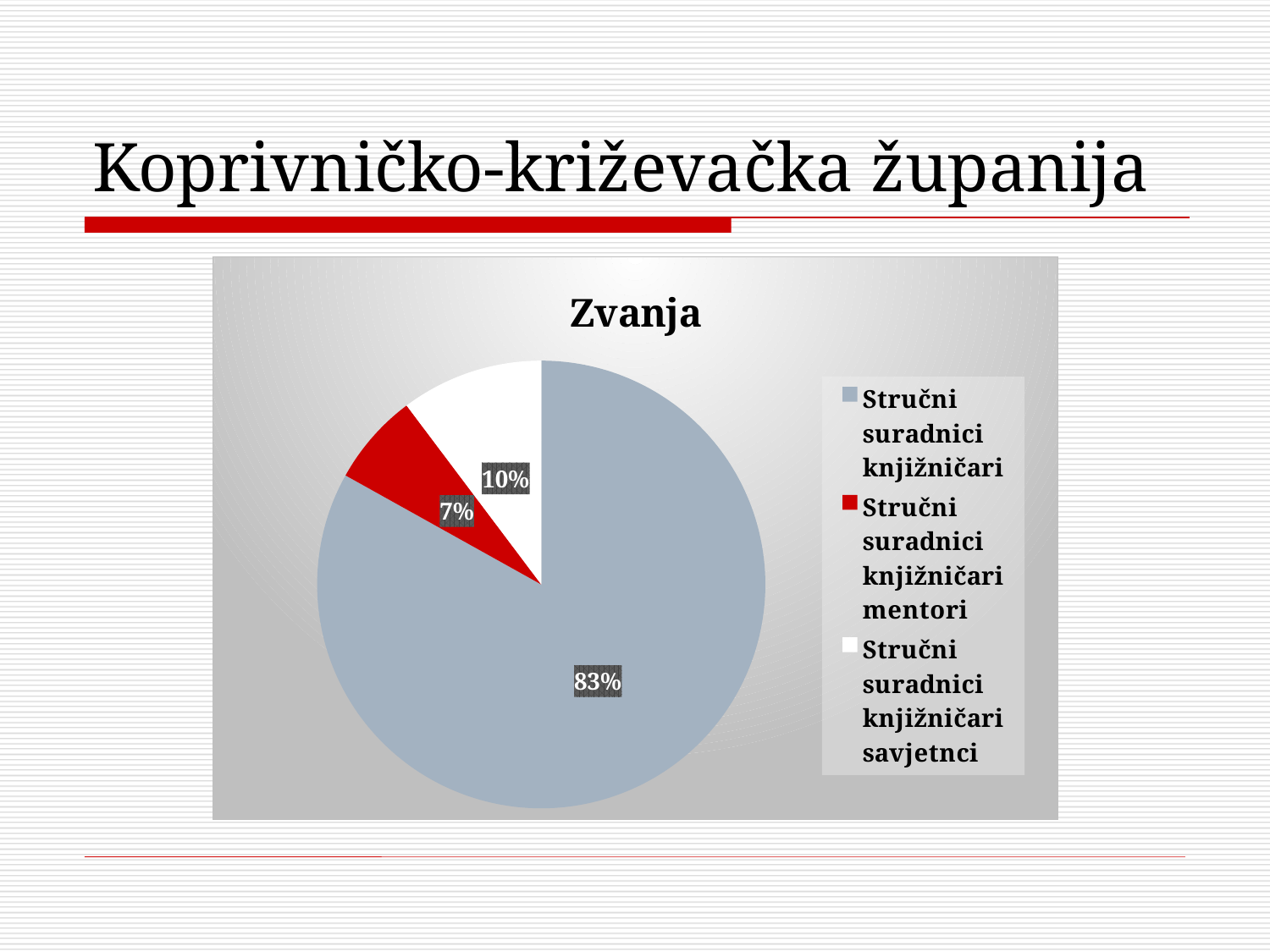
Which category has the largest slice of the pie? Stručni suradnici knjižničari How many entries does the legend list? 3 What share of the pie is labelled for Stručni suradnici knjižničari mentori? 7% What is the title of the chart? Zvanja Which slice is larger: Stručni suradnici knjižničari mentori or Stručni suradnici knjižničari savjetnci? Stručni suradnici knjižničari savjetnci What share of the pie is labelled for Stručni suradnici knjižničari? 83% Which category has the smallest slice of the pie? Stručni suradnici knjižničari mentori How many slices does the pie chart have? 3 What colour is the slice for Stručni suradnici knjižničari mentori? red What is the difference in percentage points between the Stručni suradnici knjižničari slice and the Stručni suradnici knjižničari savjetnci slice? 73 What share of the pie is labelled for Stručni suradnici knjižničari savjetnci? 10% What kind of chart is shown on the slide? pie chart